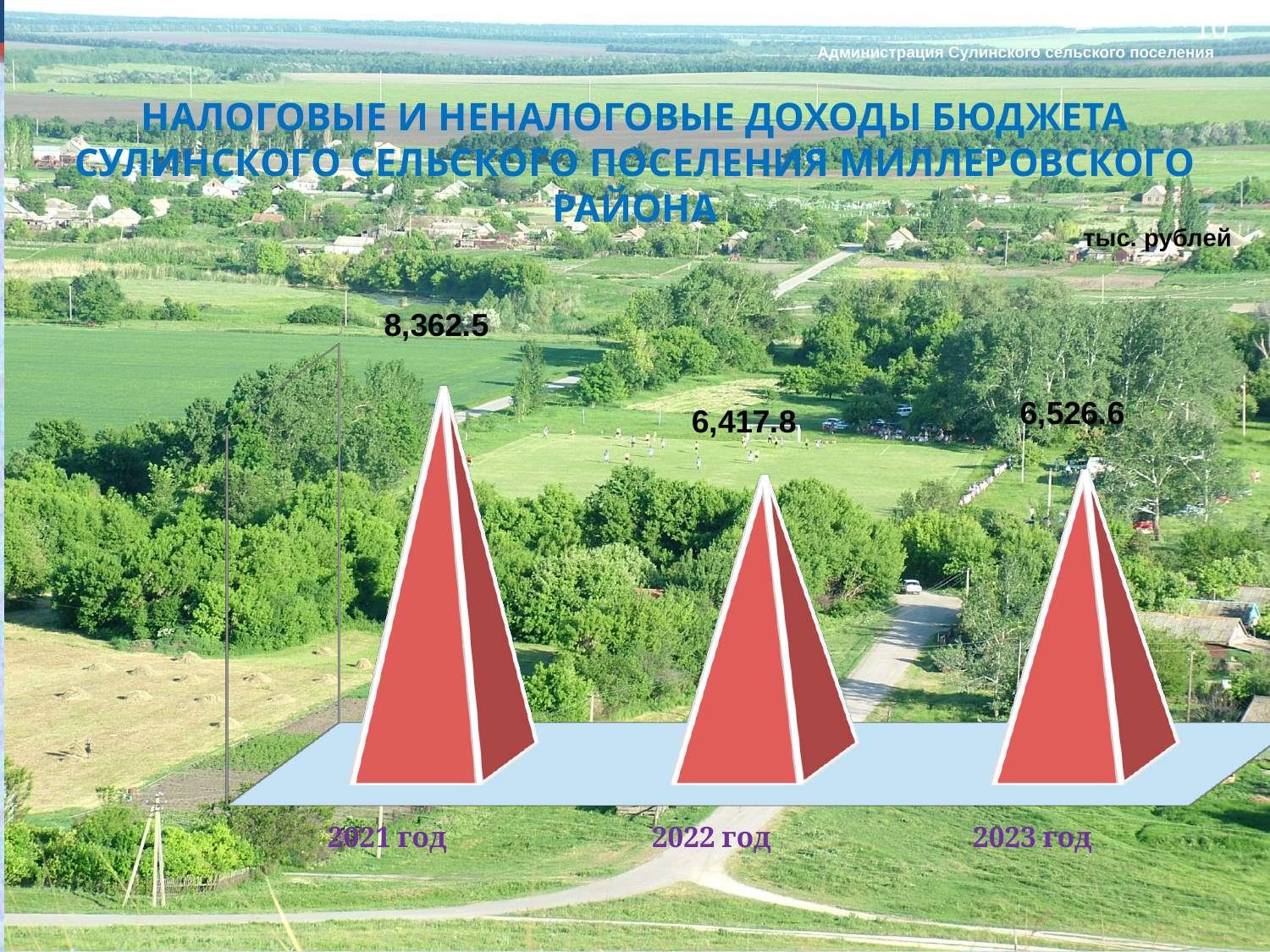
What kind of chart is shown on the slide? bar chart How many years are shown on the chart? 3 What is the difference between the values for 2021 год and 2022 год? 1,944.7 Which year has the lowest value? 2022 год Which is larger, the value for 2022 год or the value for 2023 год? 2023 год What unit of measurement is indicated for the chart values? тыс. рублей Which year has the highest value? 2021 год What is the value for 2021 год? 8,362.5 What is the value for 2023 год? 6,526.6 What is the value for 2022 год? 6,417.8 Does the value rise or fall from 2021 год to 2022 год? fall What is the difference between the values for 2023 год and 2022 год? 108.8